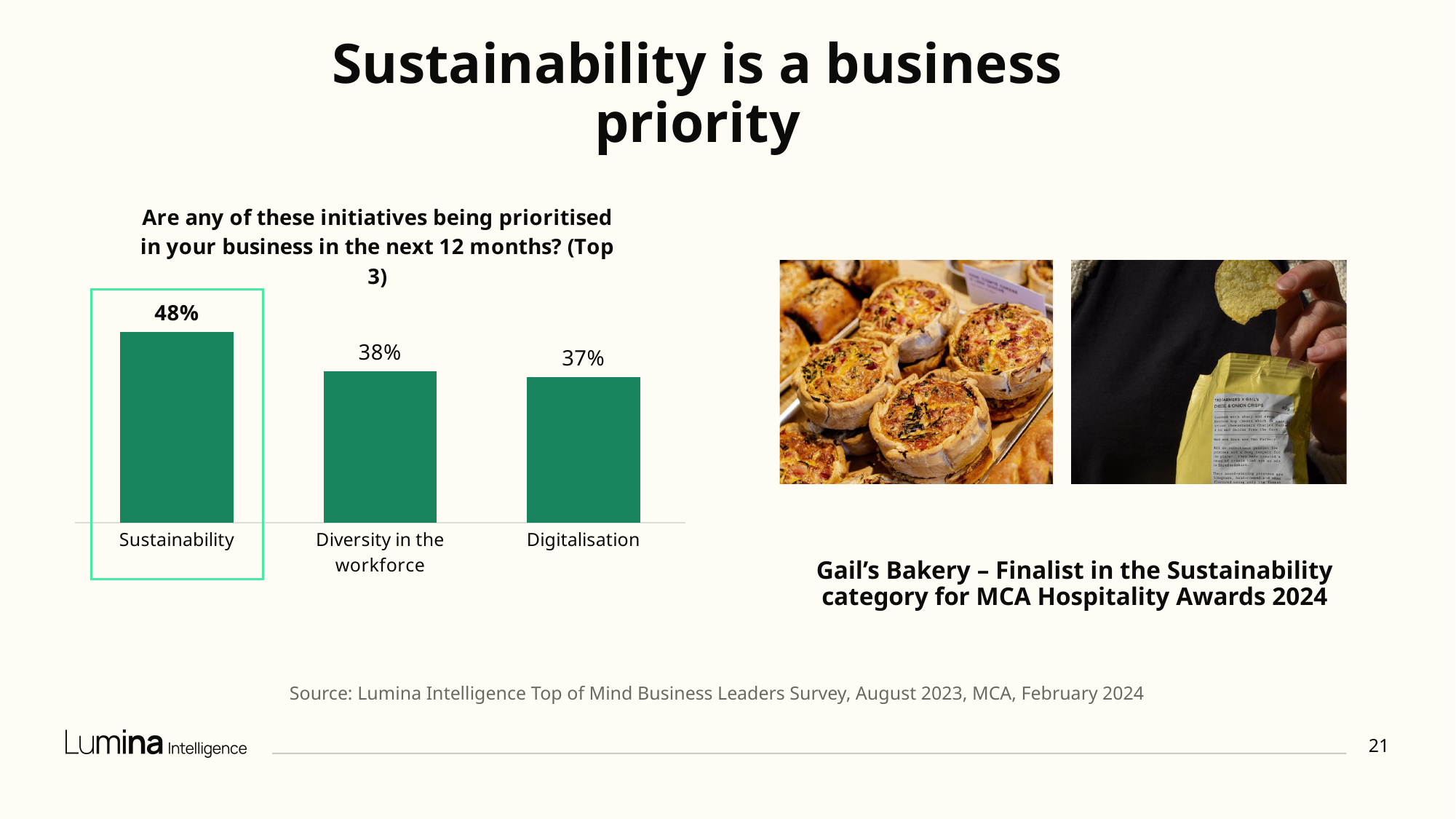
What type of chart is used to show the initiatives being prioritised? Bar chart What is the difference in percentage points between Sustainability and Diversity in the workforce? 10 percentage points Which has a higher value, Sustainability or Digitalisation? Sustainability Which initiative has the lowest percentage in the chart? Digitalisation Which initiative has the highest percentage in the chart? Sustainability What percentage of respondents said Sustainability is being prioritised in their business in the next 12 months? 48% Which bar in the chart is highlighted with a box around it? Sustainability What is the value shown for Digitalisation? 37% What is the difference in percentage points between Sustainability and Digitalisation? 11 percentage points How many initiatives are shown in the chart? 3 What is the value shown for Diversity in the workforce? 38% Do the values rise or fall from left to right across the chart? Fall